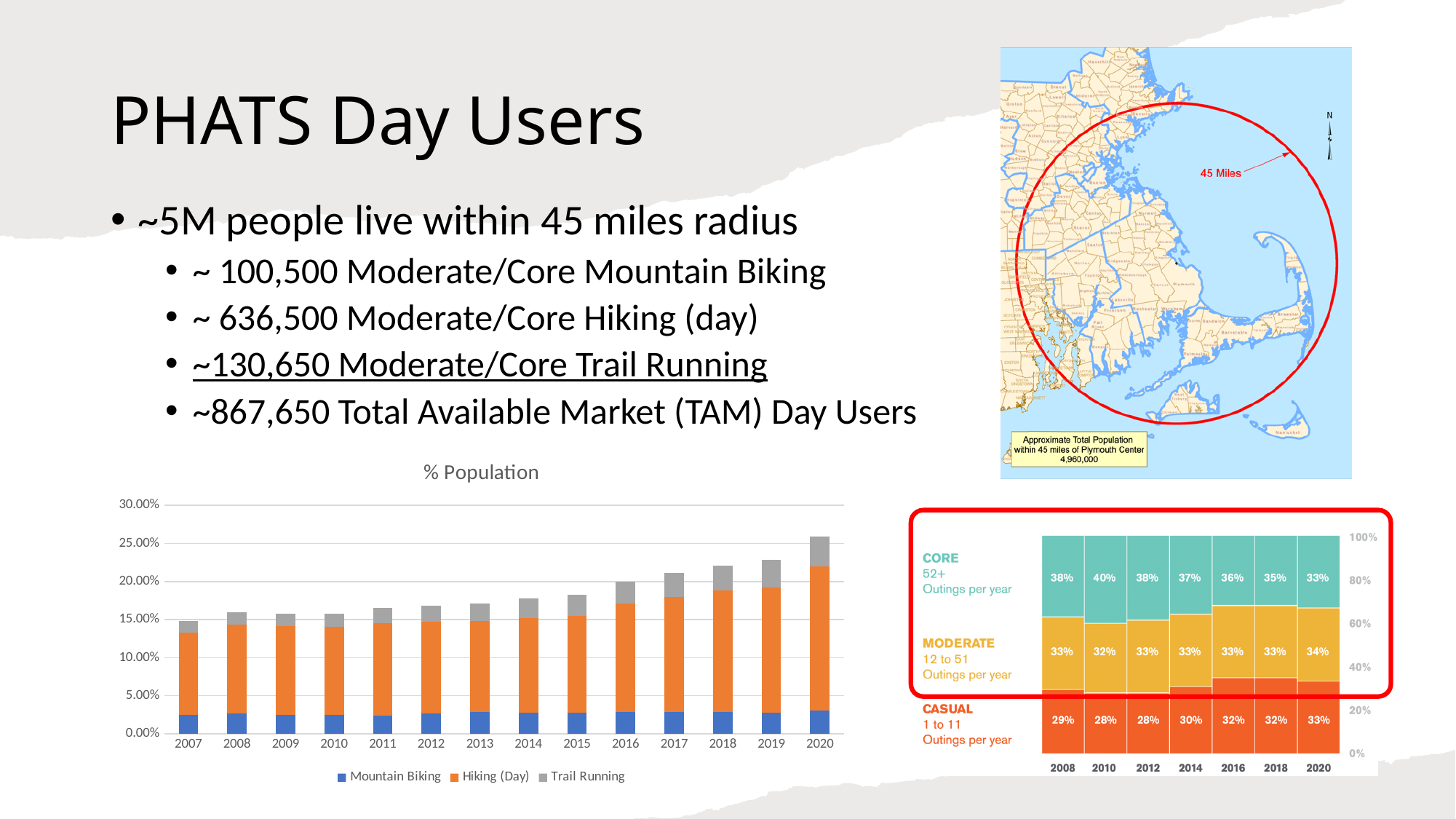
In the bottom-right CORE/MODERATE/CASUAL chart, what is the CORE value for 2008? 38% In the bottom-right CORE/MODERATE/CASUAL chart, how many years are shown on the x axis? 7 How many series does the legend of the '% Population' chart list? 3 In the bottom-right CORE/MODERATE/CASUAL chart, what is the difference between the CORE and CASUAL values for 2008? 9% In the bottom-right CORE/MODERATE/CASUAL chart, what is the CASUAL value for 2020? 33% In the '% Population' chart, which year has the tallest stacked bar? 2020 In the bottom-right CORE/MODERATE/CASUAL chart, which year has the highest CORE value? 2010 What kind of chart is the '% Population' chart? bar chart In the '% Population' chart, is the total for 2016 greater or less than 15.00%? greater In the '% Population' chart, is the total for 2020 greater or less than 20.00%? greater In the '% Population' chart, do the total bar heights generally rise or fall from 2007 to 2020? rise How many years are shown on the x axis of the '% Population' chart? 14